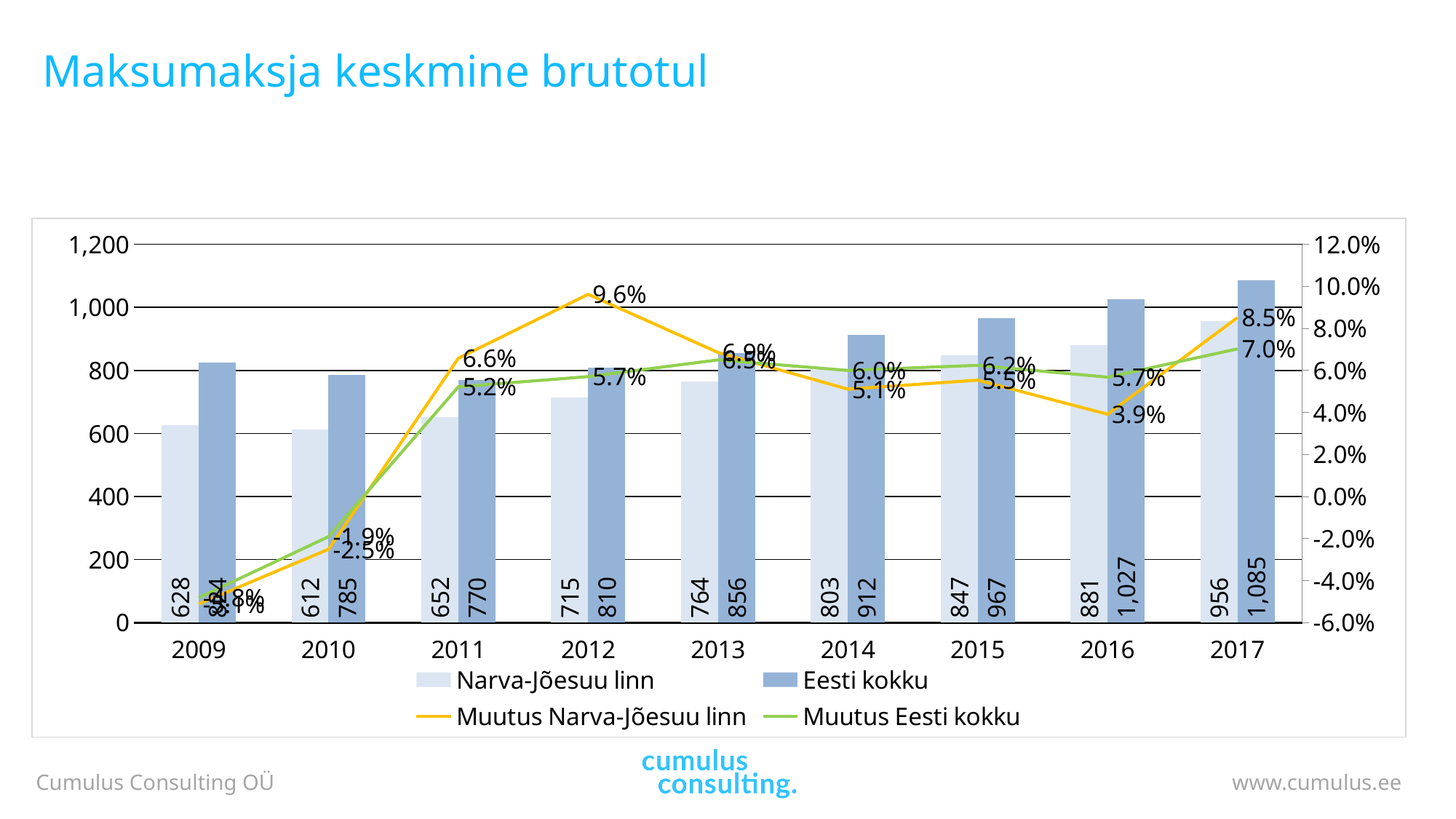
How many series does the legend list? 4 In which year is the Eesti kokku bar highest? 2017 In 2012, which is larger: Narva-Jõesuu linn or Eesti kokku? Eesti kokku In which year does the Muutus Narva-Jõesuu linn line reach its highest value? 2012 What is the value for Eesti kokku in 2016? 1,027 In which year is the Narva-Jõesuu linn bar lowest? 2010 What is the value of Muutus Eesti kokku in 2010? -1.9% What is the value for Narva-Jõesuu linn in 2017? 956 How many years are shown on the x axis? 9 What is the value of Muutus Narva-Jõesuu linn in 2012? 9.6% What is the difference between Eesti kokku and Narva-Jõesuu linn in 2017? 129 What kind of chart is shown on the slide? Combination bar and line chart